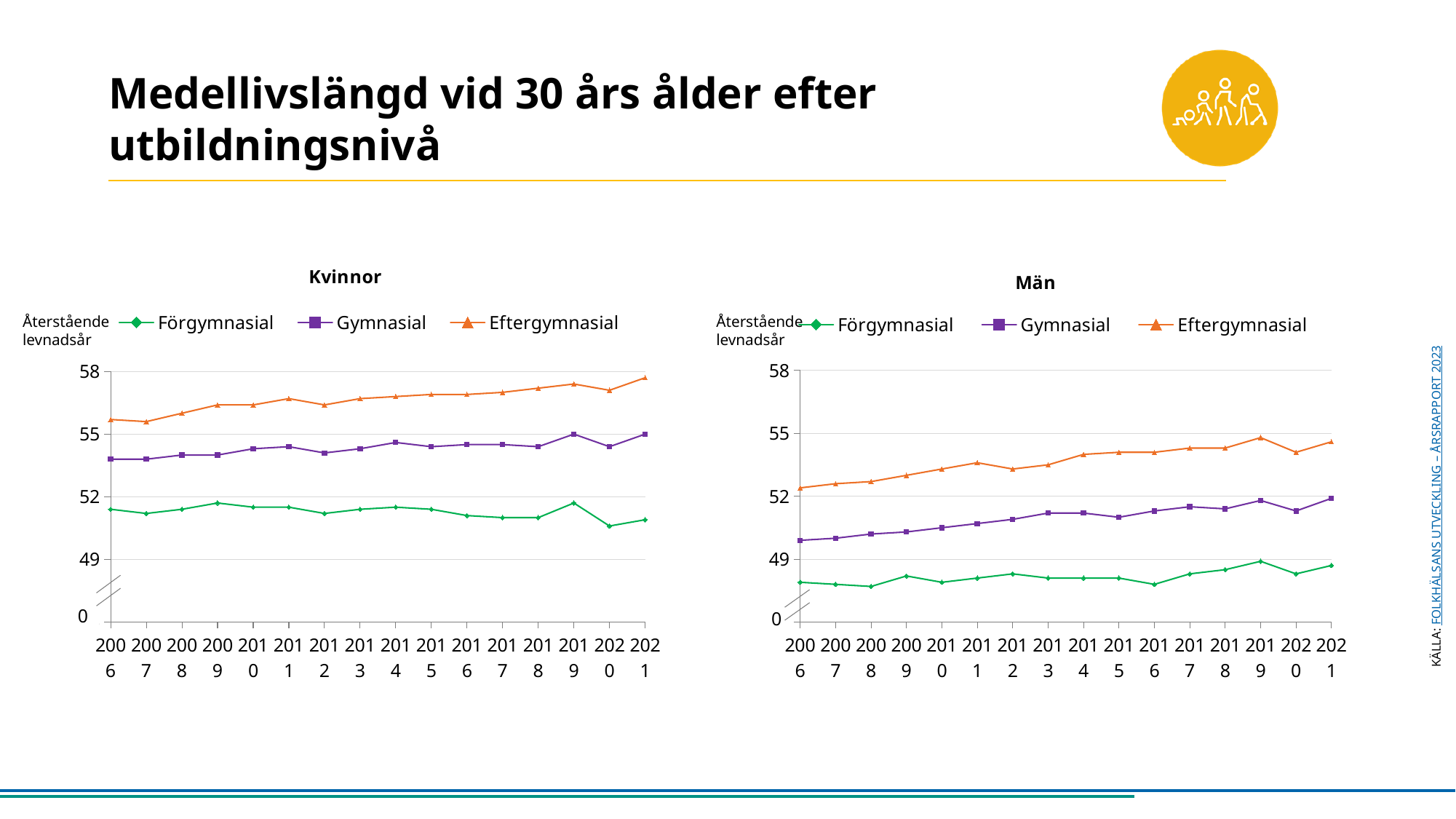
What kind of chart is the Kvinnor chart? line chart How many series does the legend of the Män chart list? 3 How many years are plotted along the x axis of the Kvinnor chart? 16 In the Män chart, does the Gymnasial series generally rise or fall from 2006 to 2021? rise In the Män chart, which series has the lowest values throughout the period? Förgymnasial In the Kvinnor chart, which series has the highest values throughout the period? Eftergymnasial In the Kvinnor chart, is the value for Eftergymnasial in 2021 greater or less than 55? greater Which is larger: the Eftergymnasial value in 2021 in the Kvinnor chart or in the Män chart? Kvinnor In the Män chart, is the value for Förgymnasial in 2006 greater or less than 49? less What is the title of the chart on the right? Män In the Män chart, is the value for Gymnasial in 2006 greater or less than 49? greater